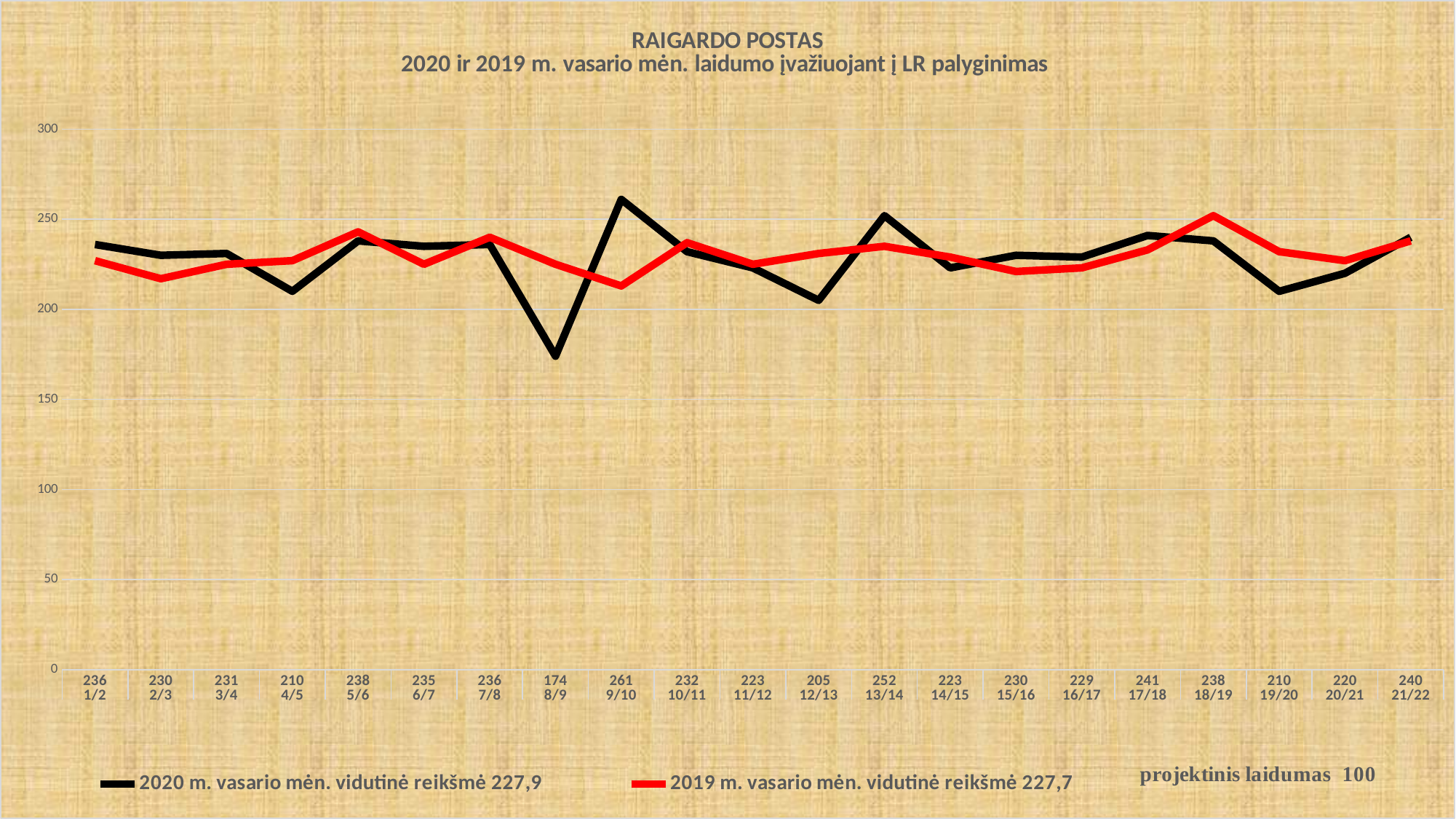
What average value (vidutinė reikšmė) does the legend give for the 2020 series? 227,9 How many series does the legend list? 2 At which x-axis category is the 2020 value lowest? 8/9 What is the 2020 value at 8/9? 174 How many x-axis categories are plotted? 21 Is the 2019 value at 8/9 greater or less than 200? greater What is the 2020 value at 13/14? 252 What kind of chart is shown on the slide? line chart What is the difference between the highest 2020 value (9/10) and the lowest 2020 value (8/9)? 87 What is the 2020 value at 9/10? 261 At which x-axis category is the 2020 value highest? 9/10 At 9/10, which series has the higher value, 2020 or 2019? 2020